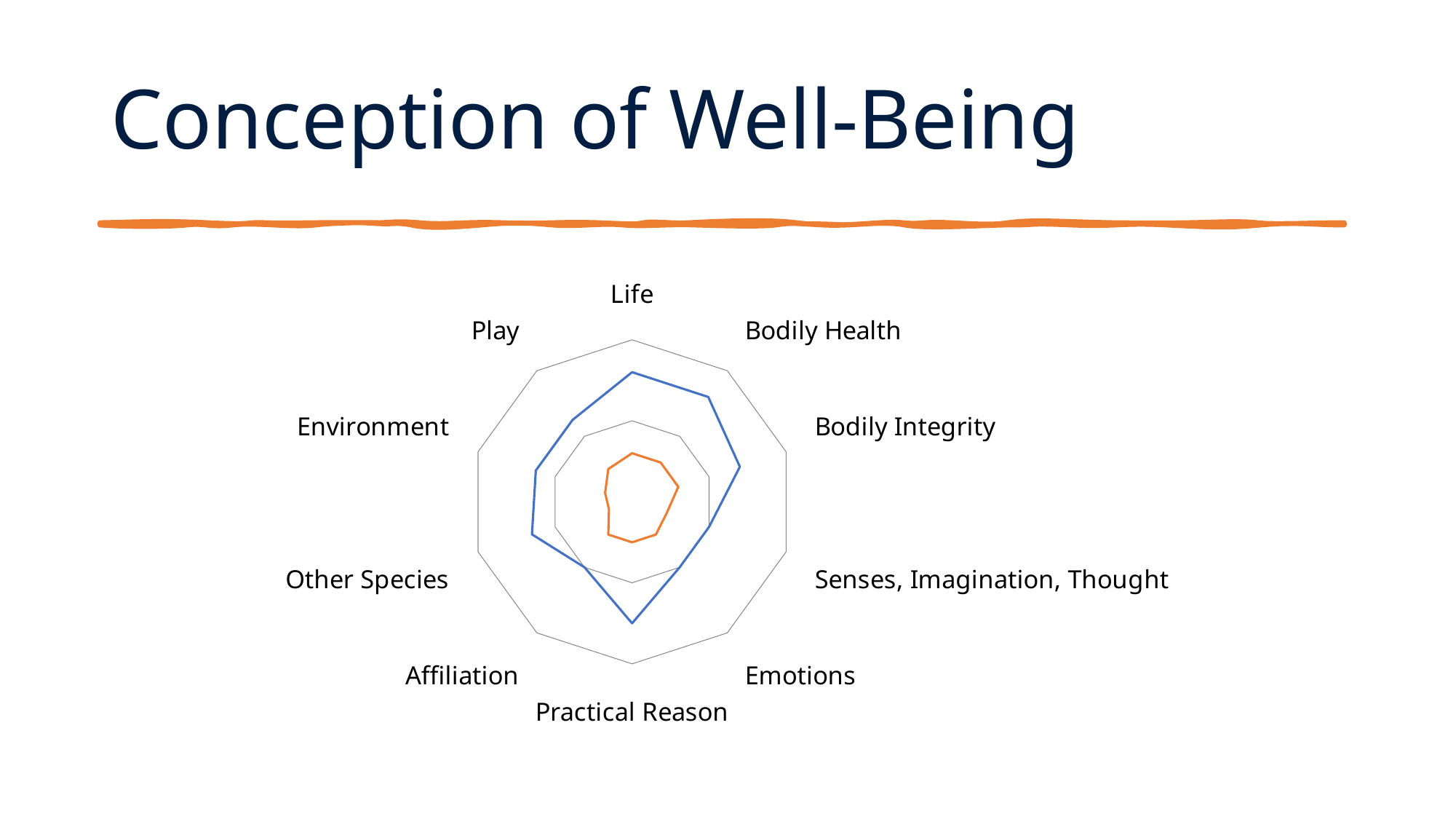
For the orange series, which category has the lowest value? Other Species What kind of chart is shown on the slide? Radar chart How many data series are plotted on the radar chart? 2 What is the title of the slide containing the radar chart? Conception of Well-Being Which series has the larger value for Life, the blue one or the orange one? Blue Which series lies entirely inside the other on the radar chart? Orange Which category label appears at the top of the radar chart? Life Which series has the larger value for Practical Reason, the blue one or the orange one? Blue How many categories (axes) does the radar chart have? 10